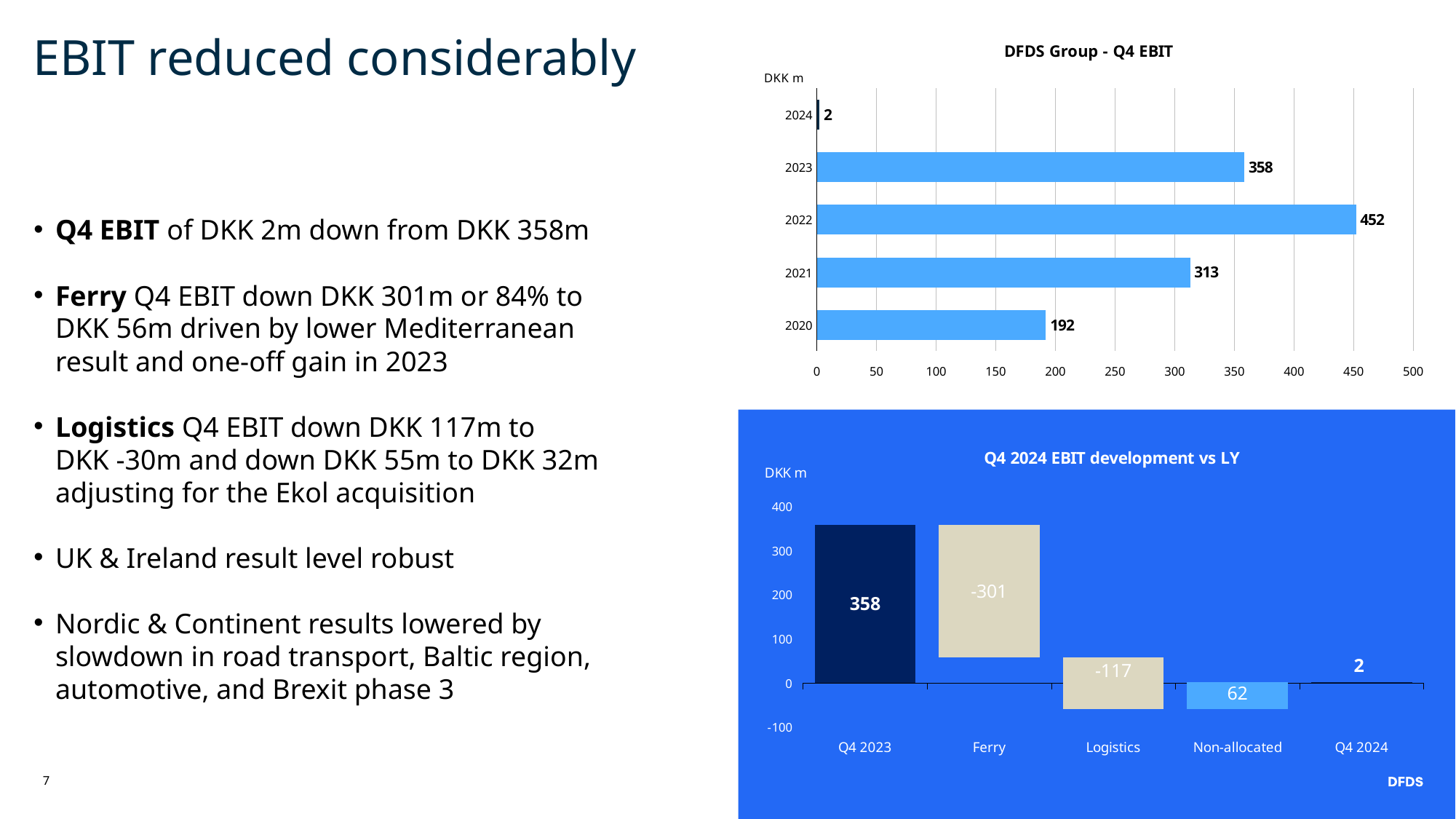
In the 'Q4 2024 EBIT development vs LY' chart, what is the difference between the Q4 2023 value and the Q4 2024 value? 356 What unit is shown on the axis label of the 'Q4 2024 EBIT development vs LY' chart? DKK m In the 'DFDS Group - Q4 EBIT' chart, which is larger, the value for 2021 or the value for 2023? 2023 How many years are shown in the 'DFDS Group - Q4 EBIT' chart? 5 In the 'Q4 2024 EBIT development vs LY' chart, what is the value shown for Non-allocated? 62 In the 'DFDS Group - Q4 EBIT' chart, which year has the lowest Q4 EBIT? 2024 In the 'DFDS Group - Q4 EBIT' chart, what is the value for 2020? 192 In the 'DFDS Group - Q4 EBIT' chart, which year has the highest Q4 EBIT? 2022 In the 'Q4 2024 EBIT development vs LY' chart, what is the value shown for Ferry? -301 In the 'DFDS Group - Q4 EBIT' chart, what is the difference between the 2023 and 2024 values? 356 In the 'DFDS Group - Q4 EBIT' chart, what is the value for 2022? 452 What type of chart is the 'DFDS Group - Q4 EBIT' chart? Bar chart